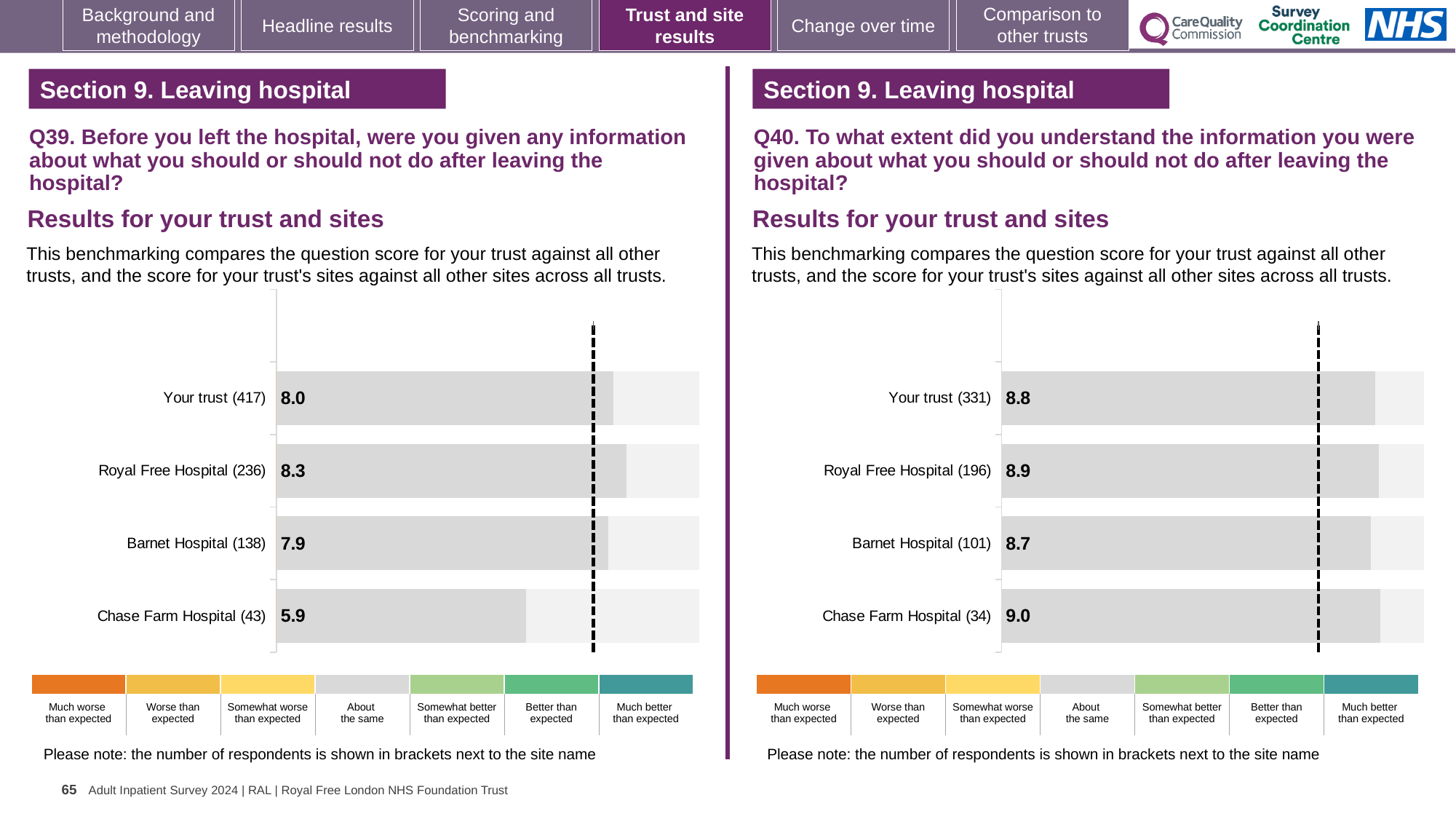
In the Q39 chart on the left, what is the score for Chase Farm Hospital? 5.9 In the Q40 chart on the right, what is the score for Your trust? 8.8 In the Q40 chart on the right, what is the difference between the scores for Chase Farm Hospital and Barnet Hospital? 0.3 In the Q39 chart on the left, which site or trust has the highest score? Royal Free Hospital In the Q40 chart on the right, what is the score for Barnet Hospital? 8.7 In the Q39 chart on the left, which site or trust has the lowest score? Chase Farm Hospital How many sites or trusts are plotted in the Q40 chart on the right? 4 In the Q39 chart on the left, what is the score for Royal Free Hospital? 8.3 In the Q40 chart on the right, which site or trust has the highest score? Chase Farm Hospital In the Q39 chart on the left, what is the difference between the scores for Royal Free Hospital and Chase Farm Hospital? 2.4 What kind of chart is used for the Q39 results on the left? Bar chart In the Q39 chart on the left, which has a higher score, Your trust or Barnet Hospital? Your trust